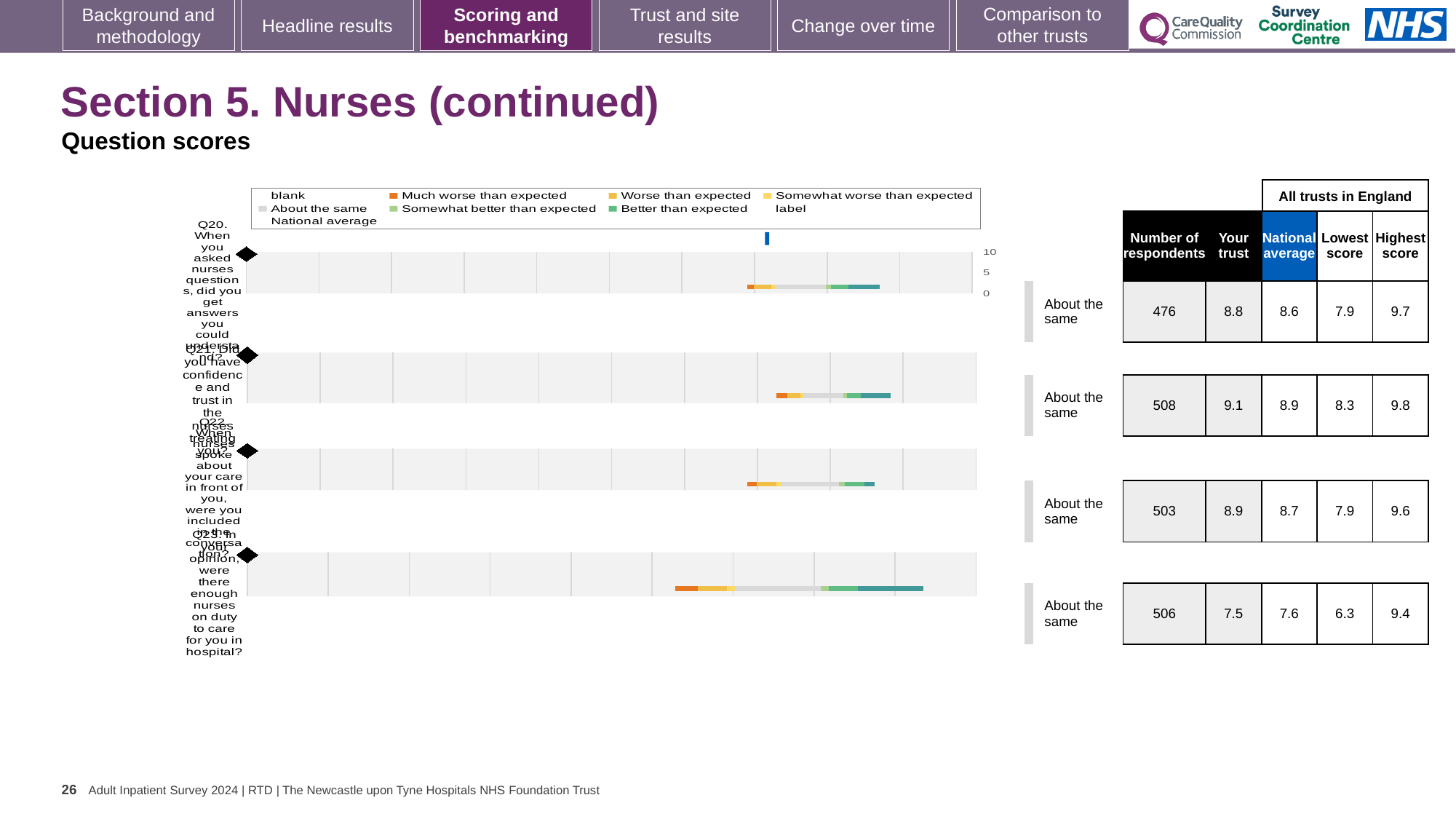
What benchmark category is shown beside each of the four question charts? About the same Which question chart (Q20, Q21, Q22 or Q23) has the highest 'Your trust' score in the table? Q21 How many question charts (Q20 to Q23) are shown on the slide? 4 For the Q20 chart, what is the 'Your trust' score shown in the table beside it? 8.8 What kind of chart is used for the Q20 row on the slide? bar chart For the Q23 chart, what is the 'Your trust' score shown in the table beside it? 7.5 Which question chart (Q20, Q21, Q22 or Q23) has the lowest 'Your trust' score in the table? Q23 What is the difference between the 'Your trust' score and the 'National average' for the Q22 chart? 0.2 Which legend entry is shown in orange? Much worse than expected For the Q21 chart, what is the 'National average' score shown in the table beside it? 8.9 What is the highest tick value shown on the axis of the Q20 chart? 10 How many entries does the shared legend above the charts list? 9